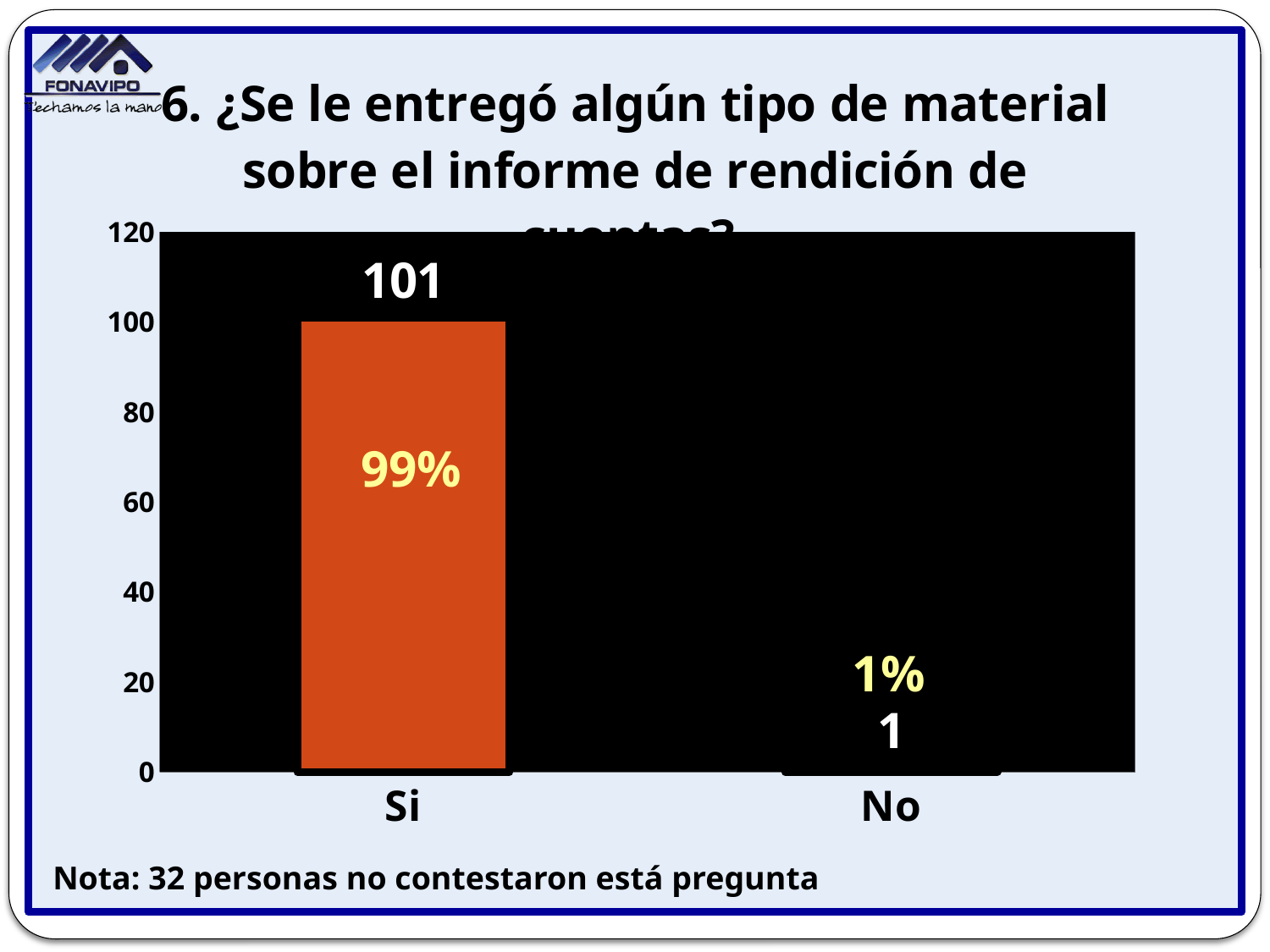
What is the value for "No"? 1 Which category has the lowest value? No What percentage is shown for "No"? 1% What is the maximum value shown on the vertical axis? 120 What kind of chart is shown on the slide? bar chart How many categories are shown on the x axis? 2 Is the value for "Si" greater or less than 80? greater Which is larger, the value for "Si" or the value for "No"? Si Which category has the highest value? Si What is the value for "Si"? 101 What is the difference between the values for "Si" and "No"? 100 What percentage is shown for "Si"? 99%